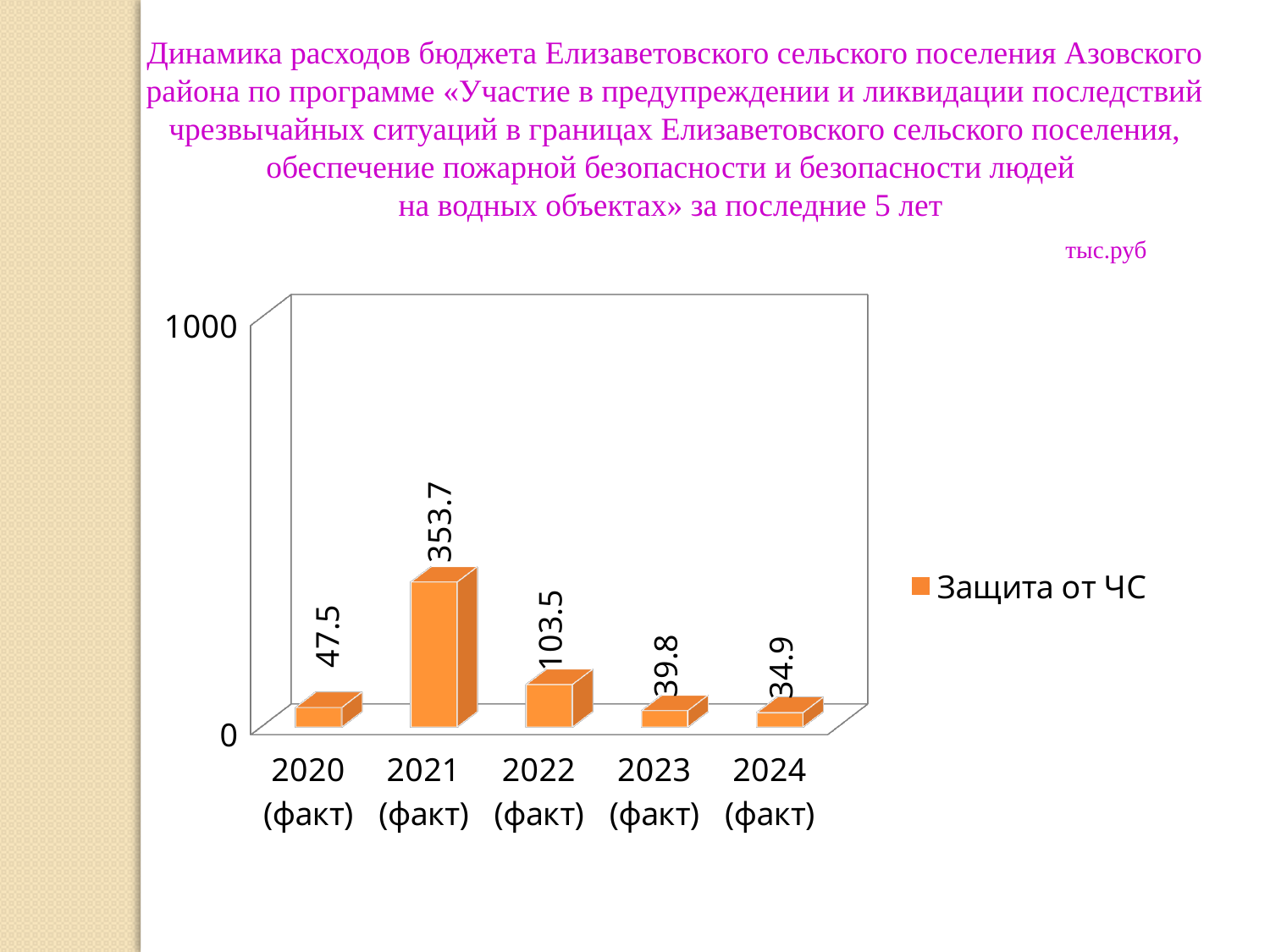
Which year has the lowest value? 2024 (факт) What is the value for 2020 (факт)? 47.5 Which year has the highest value? 2021 (факт) What is the name of the series in the legend? Защита от ЧС What is the value for 2024 (факт)? 34.9 How many years are shown on the x axis? 5 Which is larger, the value for 2020 (факт) or 2023 (факт)? 2020 (факт) What is the difference between the values for 2021 (факт) and 2022 (факт)? 250.2 What kind of chart is this? bar chart How many series does the legend list? 1 What is the value for 2022 (факт)? 103.5 What is the value for 2021 (факт)? 353.7